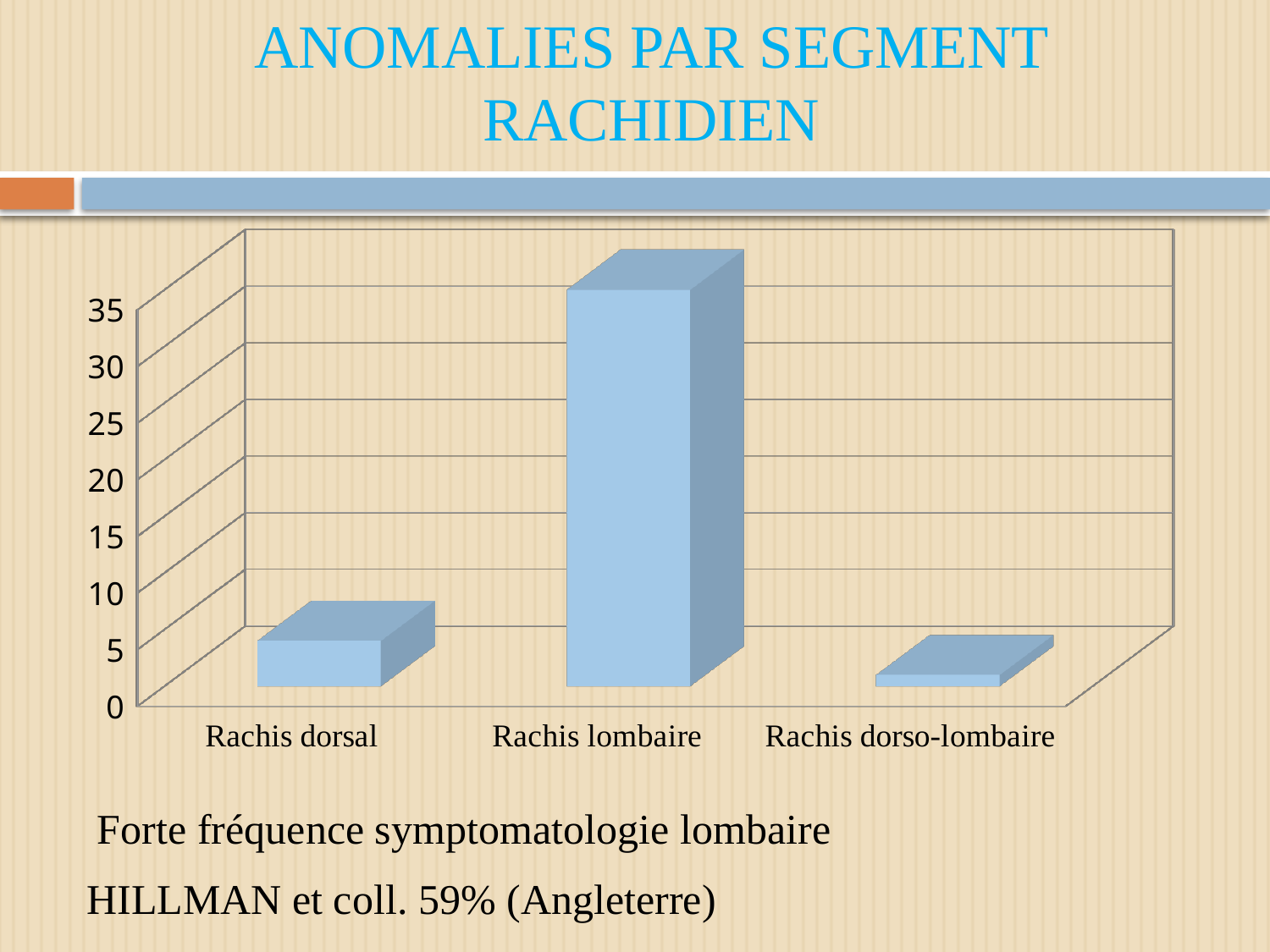
Which is larger, the value for Rachis dorsal or the value for Rachis dorso-lombaire? Rachis dorsal Is the value for Rachis dorsal greater or less than 10? less Which category has the highest value in the chart? Rachis lombaire Is the value for Rachis dorso-lombaire greater or less than 5? less What is the title of the slide containing the chart? ANOMALIES PAR SEGMENT RACHIDIEN What kind of chart is shown on the slide? bar chart What is the highest value shown on the vertical axis of the chart? 35 Which is larger, the value for Rachis dorsal or the value for Rachis lombaire? Rachis lombaire Is the value for Rachis lombaire greater or less than 25? greater Which category has the lowest value in the chart? Rachis dorso-lombaire How many categories are shown on the x axis of the chart? 3